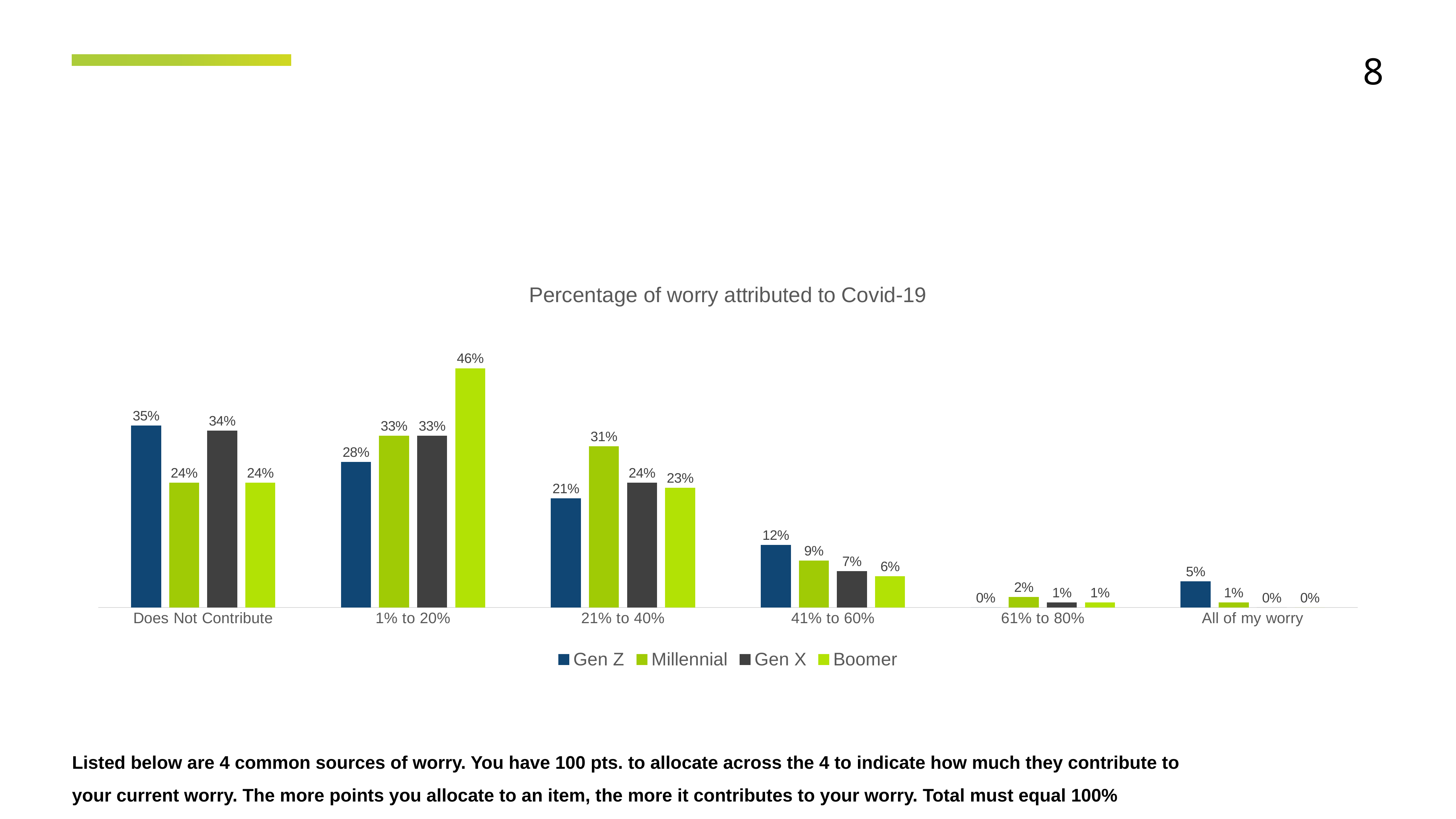
What kind of chart is shown on the slide? Bar chart What is the Millennial value for "21% to 40%"? 31% What is the Boomer value for the "1% to 20%" category? 46% What is the Gen X value for "41% to 60%"? 7% How many categories are shown on the x axis? 6 What is the title of the chart? Percentage of worry attributed to Covid-19 Which generation has the lowest value in the "Does Not Contribute" category? Millennial and Boomer (both 24%) Which is larger: the Gen Z value for "41% to 60%" or the Millennial value for "41% to 60%"? Gen Z How many series does the legend list? 4 What is the difference between the Boomer and Gen Z values in the "1% to 20%" category? 18% Which generation has the highest value in the "1% to 20%" category? Boomer What is the Gen Z value for "Does Not Contribute"? 35%